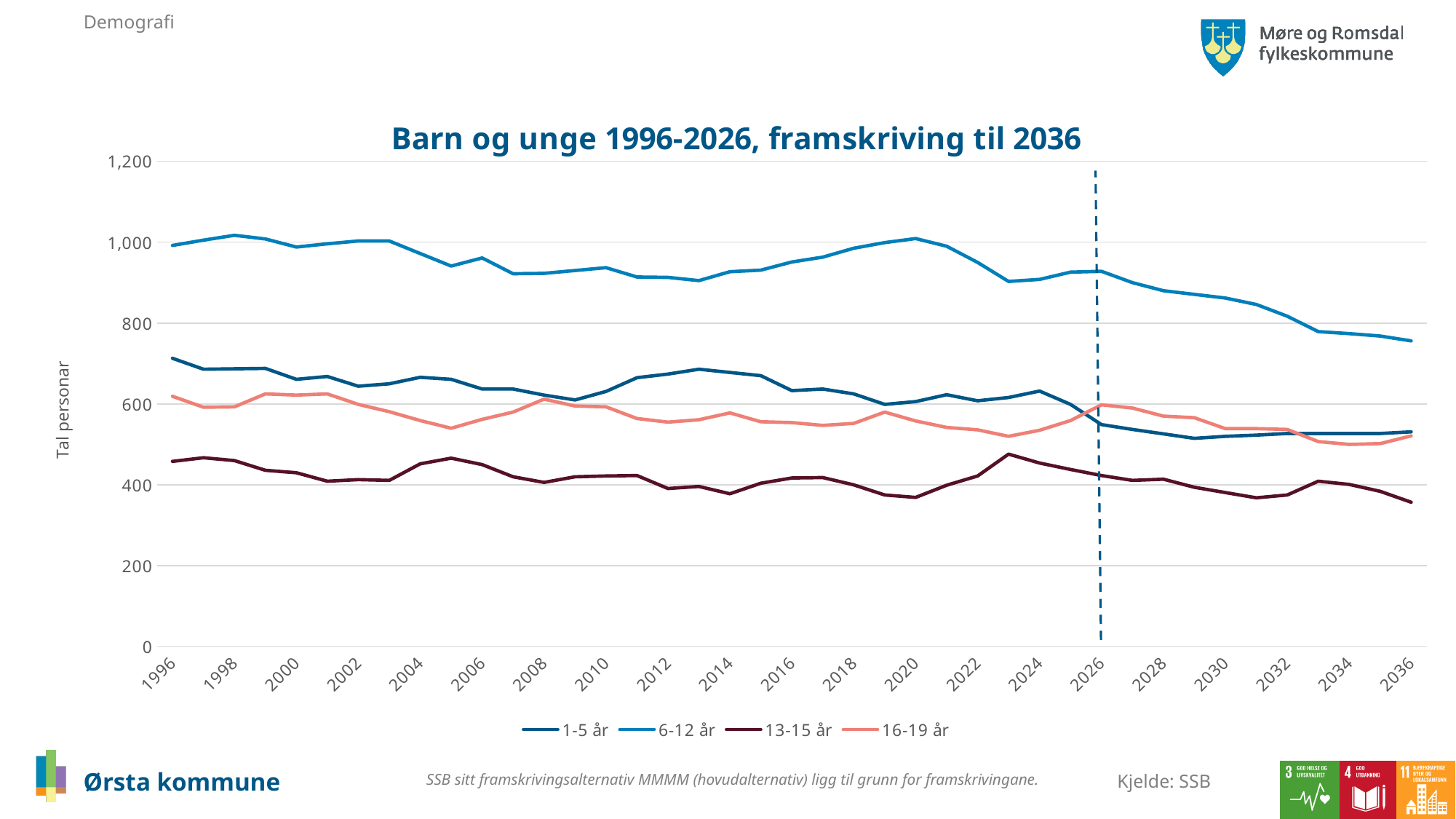
What kind of chart is shown on the slide? line chart Which series are listed in the legend? 1-5 år, 6-12 år, 13-15 år, 16-19 år Which series has the lowest values across the whole period? 13-15 år Is the value for 13-15 år in 2036 greater or less than 400? less In 1996, which is larger: the value for 1-5 år or the value for 16-19 år? 1-5 år Is the value for 1-5 år in 1996 greater or less than 600? greater What is the title of the chart? Barn og unge 1996-2026, framskriving til 2036 How many series does the legend list? 4 Which series has the highest values across the whole period? 6-12 år Is the value for 6-12 år in 2036 greater or less than 800? less Does the 6-12 år series rise or fall between 2026 and 2036? fall